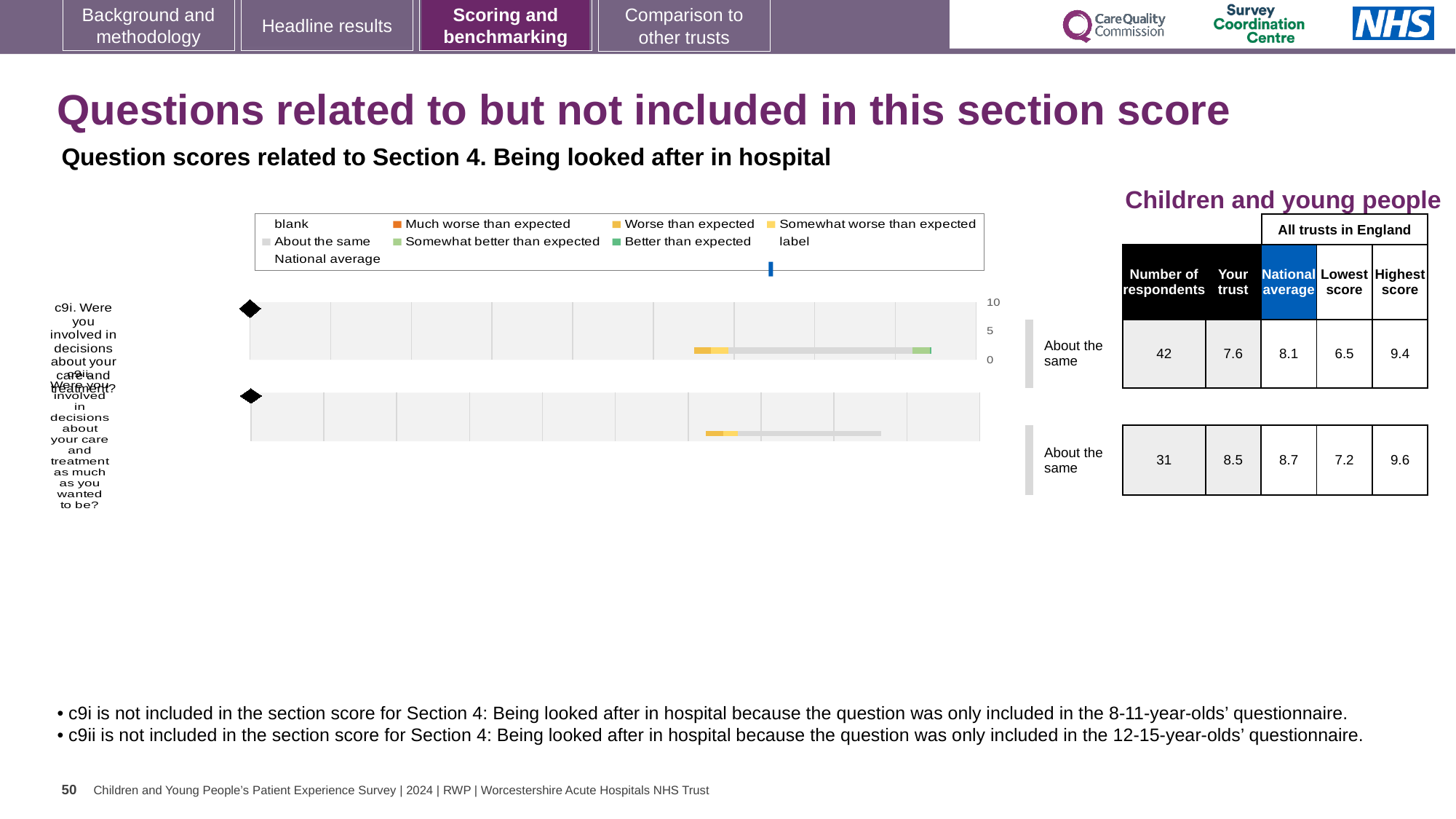
What is the national average score for question c9ii? 8.7 What is the highest score across all trusts in England for question c9ii? 9.6 How many questions (categories) are plotted in the chart? 2 What is the lowest score across all trusts in England for question c9i? 6.5 What kind of chart is shown on the slide? bar chart Which question had more respondents, c9i or c9ii? c9i For question c9i, which is higher: the trust's score or the national average? National average What is the difference between the national average and the trust's score for question c9i? 0.5 What benchmark category is shown for question c9ii? About the same What is the difference between the national average and the trust's score for question c9ii? 0.2 How many respondents answered question c9i? 42 What is the 'Your trust' score for question c9i? 7.6